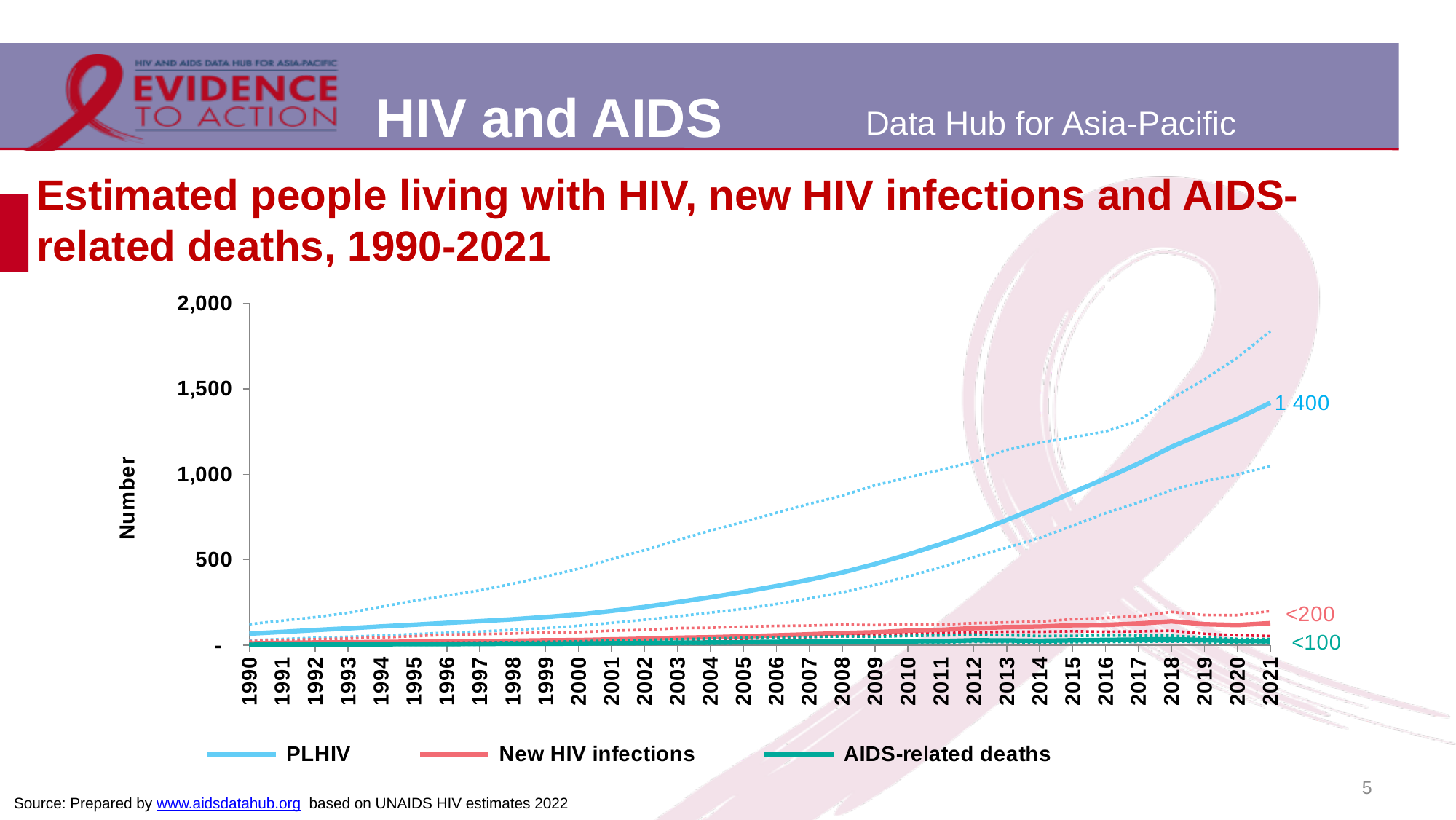
Is the value for PLHIV in 2000 greater or less than 500? less Which series has the highest value in 2021? PLHIV What is the labelled value for AIDS-related deaths in 2021? <100 Which series has the lowest value in 2021? AIDS-related deaths What is the labelled value for New HIV infections in 2021? <200 How many series does the legend list? 3 How many years are shown on the x axis? 32 What is the labelled value for PLHIV in 2021? 1 400 What kind of chart is shown on the slide? line chart Is the value for PLHIV in 2010 greater or less than 1,000? less Does the PLHIV line rise or fall from 1990 to 2021? rise In 2021, which is larger: PLHIV or New HIV infections? PLHIV